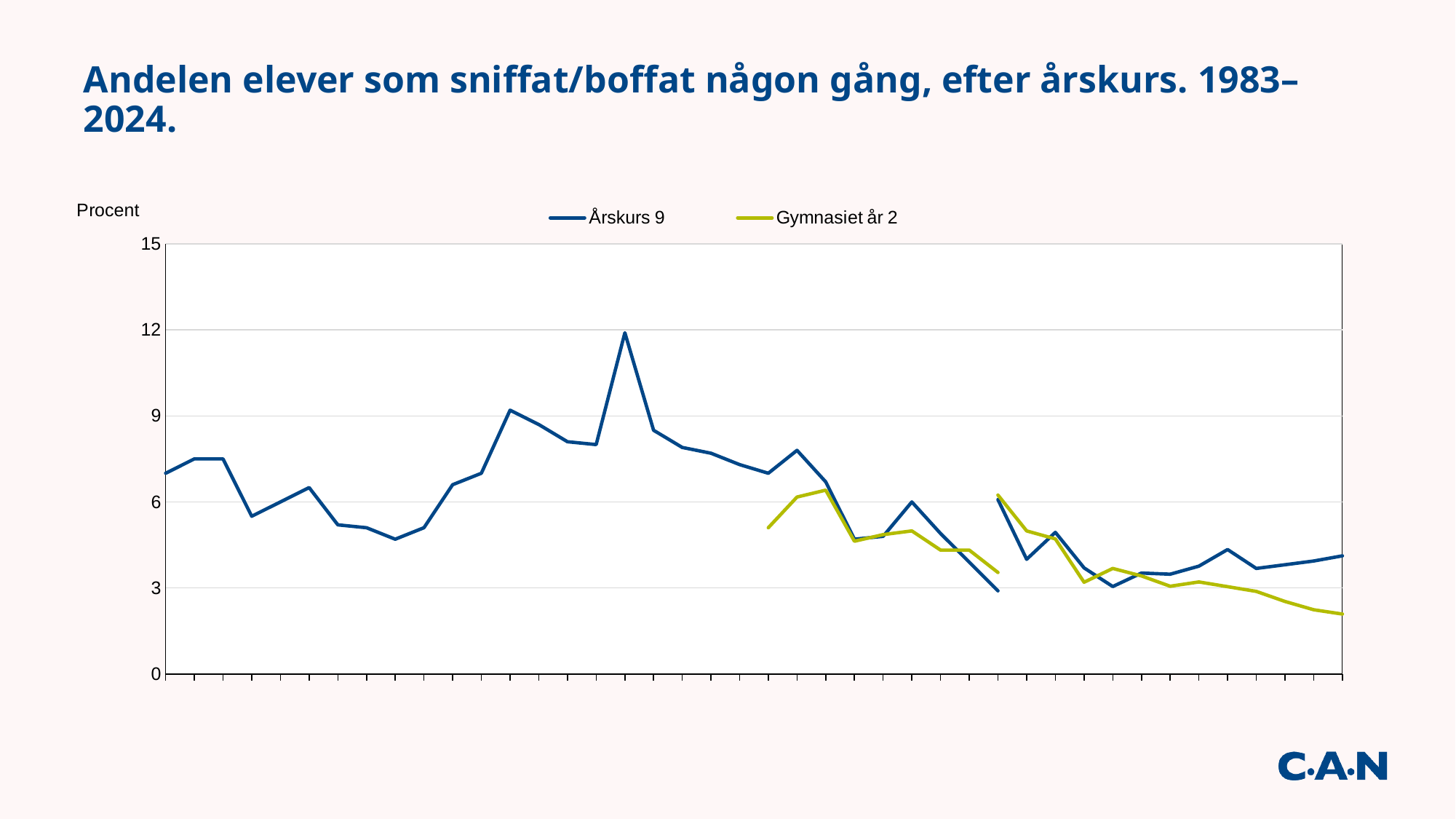
What are the two series named in the legend? Årskurs 9 and Gymnasiet år 2 Which series reaches the highest value anywhere on the chart? Årskurs 9 Is the last (rightmost) value of the Årskurs 9 series greater or less than 3? greater What kind of chart is shown on the slide? Line chart Is the last (rightmost) value of the Gymnasiet år 2 series greater or less than 3? less Is the highest value of the Årskurs 9 series greater or less than 9? greater Does the Gymnasiet år 2 series generally rise or fall from its first point to its last point? Fall What label is shown on the vertical axis of the chart? Procent Which series has the higher value at the right end of the chart, Årskurs 9 or Gymnasiet år 2? Årskurs 9 How many series does the legend list? 2